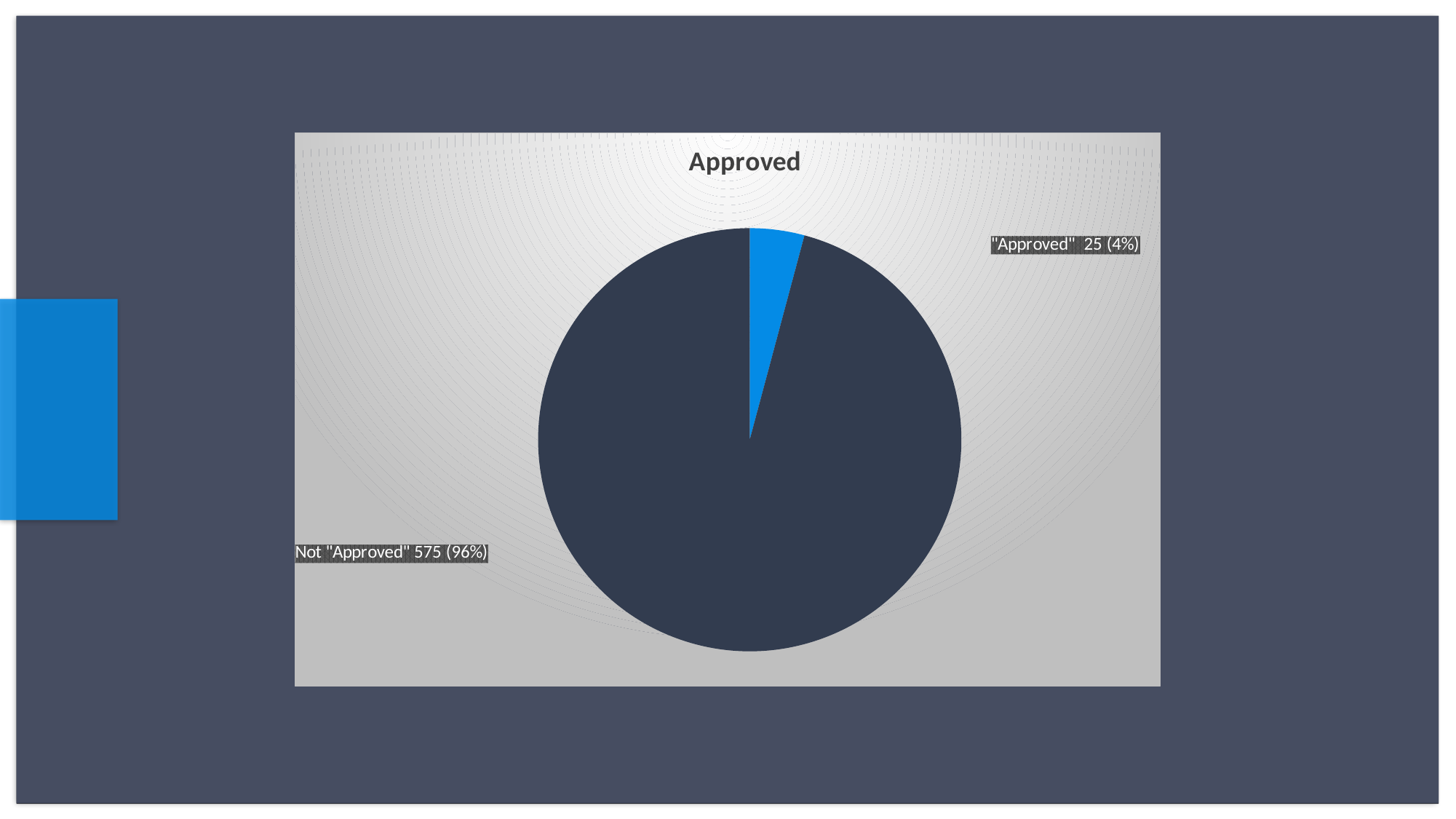
What is the value for the "Approved" slice? 25 What is the title of the chart? Approved What share of the pie does the Not "Approved" slice represent? 96% Which is larger, the "Approved" slice or the Not "Approved" slice? Not "Approved" What is the total of the two slices in the pie chart? 600 How many slices does the pie chart have? 2 What is the difference between the Not "Approved" and "Approved" values? 550 Which slice is the smallest? "Approved" What is the value for the Not "Approved" slice? 575 Which slice is the largest? Not "Approved" What share of the pie does the "Approved" slice represent? 4% What type of chart is shown on the slide? pie chart